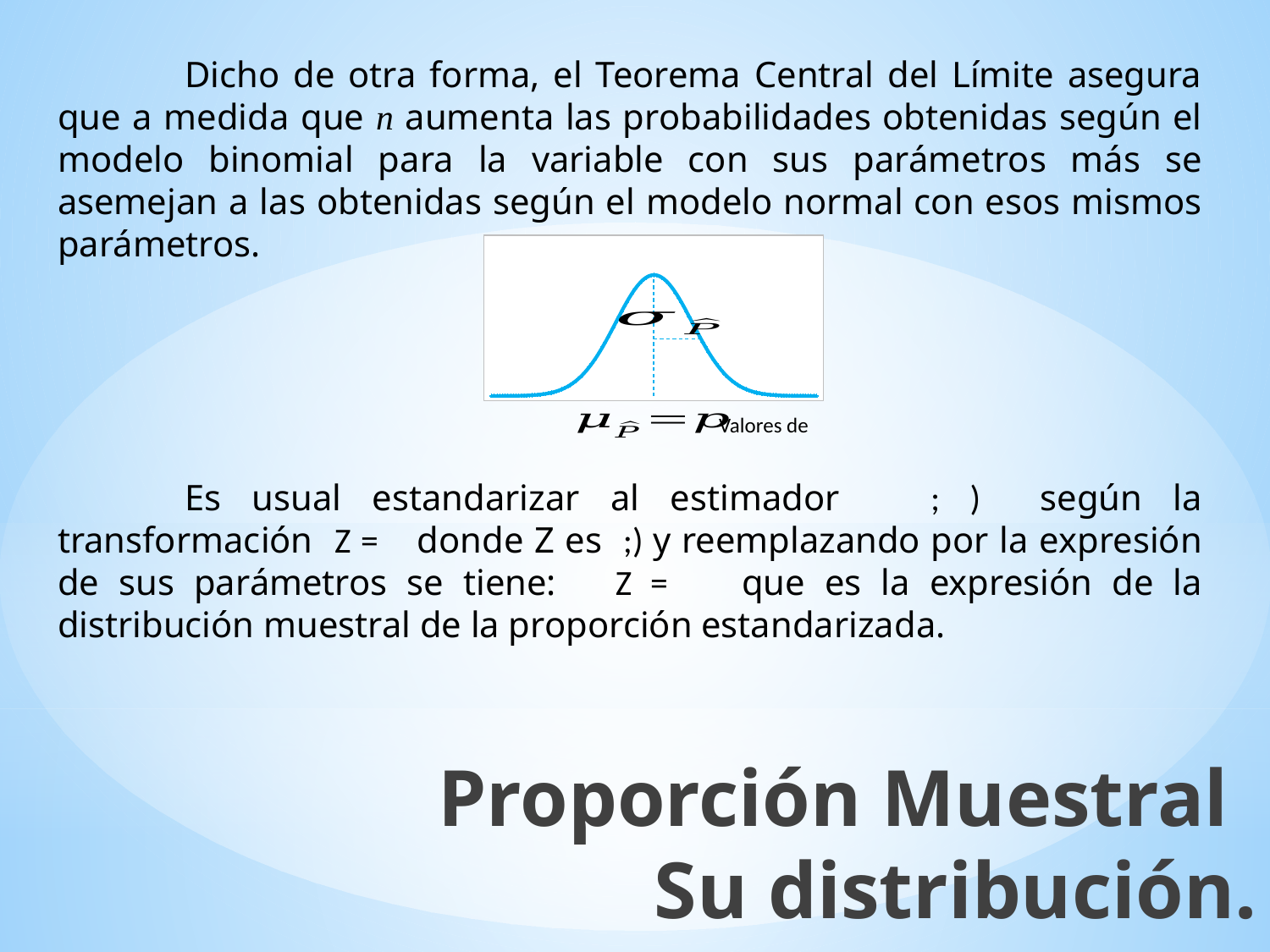
Where along the x axis does the curve in the chart reach its highest point: at the left edge, the centre, or the right edge? the centre Does the curve in the chart rise or fall as it moves from the left edge toward the centre? rise What kind of chart is shown in the middle of the slide? line chart What symbol is written next to the dashed horizontal segment inside the curve on the chart? σ p̂ How many curves are plotted in the chart on the slide? 1 Does the curve in the chart rise or fall as it moves from the centre toward the right edge? fall What colour is the curve plotted in the chart on the slide? blue